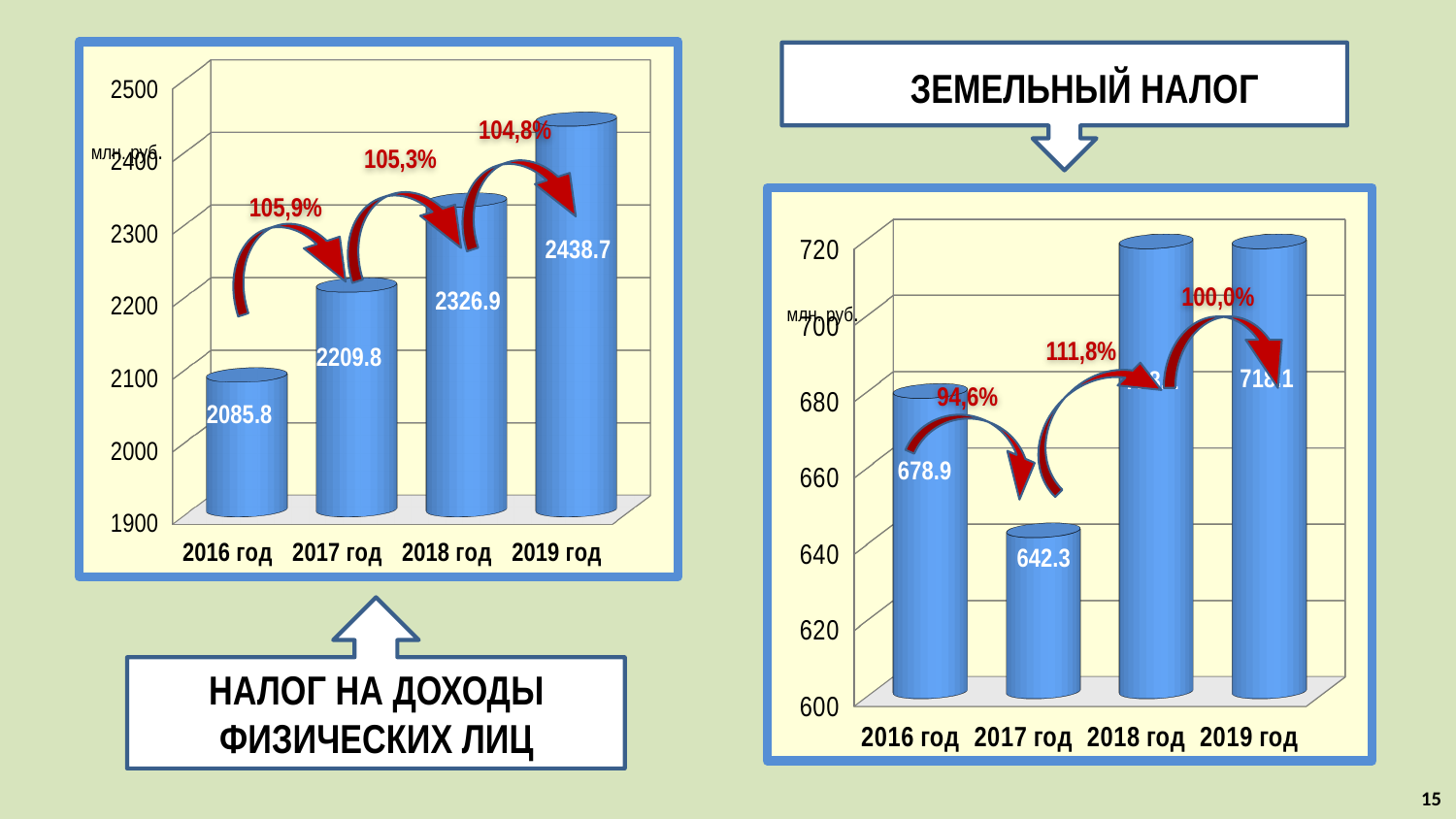
In the chart titled НАЛОГ НА ДОХОДЫ ФИЗИЧЕСКИХ ЛИЦ, what is the value for 2019 год? 2438.7 How many years are shown in the chart titled НАЛОГ НА ДОХОДЫ ФИЗИЧЕСКИХ ЛИЦ? 4 What kind of chart is the one titled ЗЕМЕЛЬНЫЙ НАЛОГ? bar chart In the chart titled НАЛОГ НА ДОХОДЫ ФИЗИЧЕСКИХ ЛИЦ, which year has the highest value? 2019 год In the chart titled ЗЕМЕЛЬНЫЙ НАЛОГ, which year has the lowest value? 2017 год In the chart titled ЗЕМЕЛЬНЫЙ НАЛОГ, which is larger, the value for 2016 год or 2017 год? 2016 год In the chart titled ЗЕМЕЛЬНЫЙ НАЛОГ, what is the difference between the values for 2016 год and 2017 год? 36.6 In the chart titled НАЛОГ НА ДОХОДЫ ФИЗИЧЕСКИХ ЛИЦ, what is the value for 2016 год? 2085.8 In the chart titled НАЛОГ НА ДОХОДЫ ФИЗИЧЕСКИХ ЛИЦ, do the values rise or fall from 2016 год to 2019 год? rise In the chart titled ЗЕМЕЛЬНЫЙ НАЛОГ, what is the value for 2017 год? 642.3 In the chart titled НАЛОГ НА ДОХОДЫ ФИЗИЧЕСКИХ ЛИЦ, what is the difference between the values for 2019 год and 2016 год? 352.9 In the chart titled ЗЕМЕЛЬНЫЙ НАЛОГ, is the value for 2018 год greater or less than 700? greater